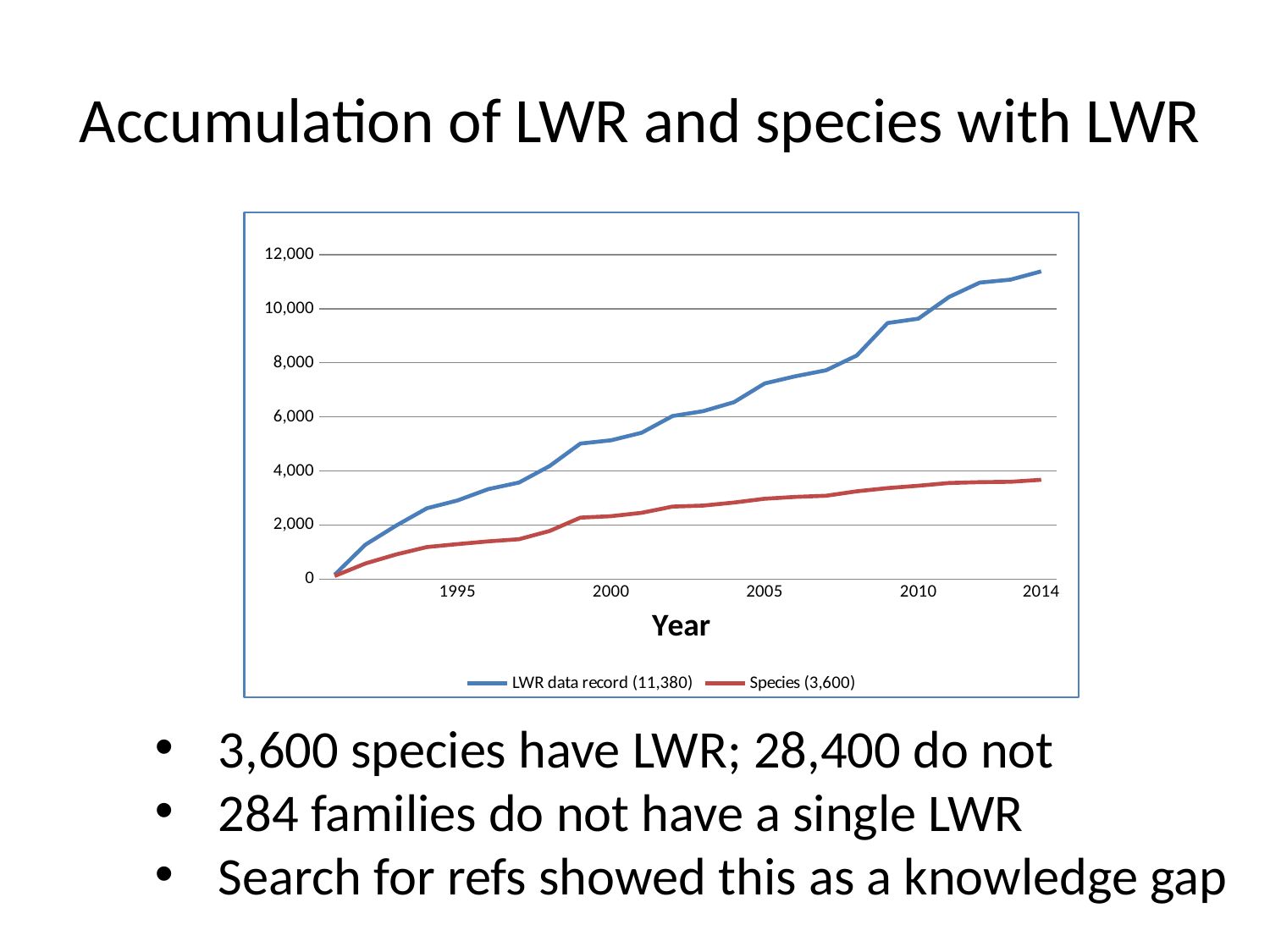
Is the value for Species in 2005 greater or less than 4,000? less How many series does the chart's legend list? 2 Is the value for Species in 1995 greater or less than 2,000? less What are the two series named in the legend? LWR data record (11,380) and Species (3,600) What kind of chart is shown on the slide? line chart What is the label of the chart's x axis? Year Do the values of the Species series rise or fall over the years shown? rise Is the value for LWR data record in 2010 greater or less than 8,000? greater Which series has the higher value in 2014, LWR data record or Species? LWR data record Do the values of the LWR data record series rise or fall from 1995 to 2014? rise